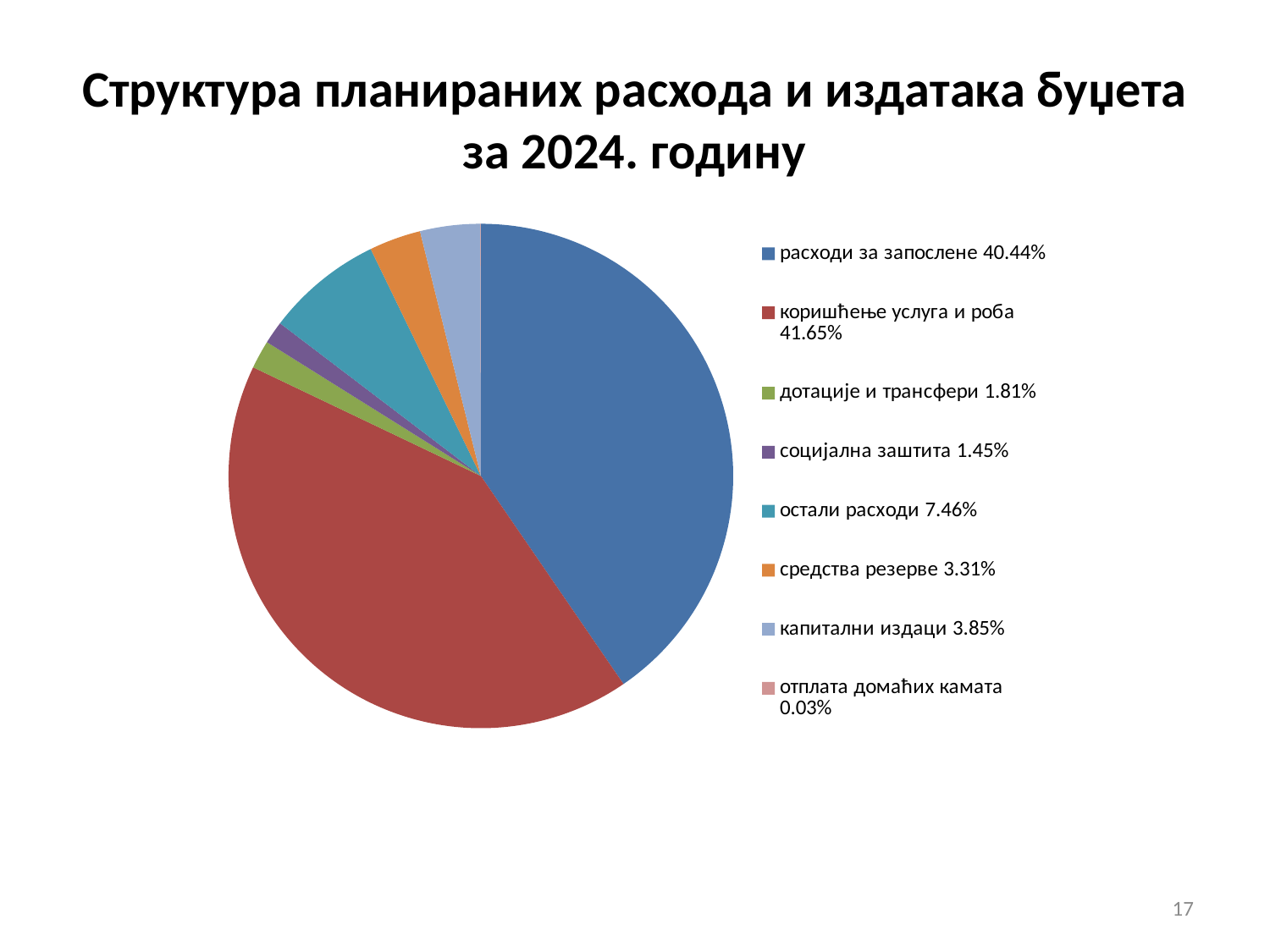
What is the share for капитални издаци? 3.85% How many categories does the legend list? 8 What is the share for расходи за запослене? 40.44% What is the share for отплата домаћих камата? 0.03% What is the title of the chart slide? Структура планираних расхода и издатака буџета за 2024. годину Which category has the largest share of the pie? коришћење услуга и роба What kind of chart is shown on the slide? pie chart Which category has the smallest share of the pie? отплата домаћих камата What is the share for остали расходи? 7.46% What is the share for коришћење услуга и роба? 41.65% Which is larger, the share for средства резерве or the share for капитални издаци? капитални издаци What is the difference between the shares of коришћење услуга и роба and расходи за запослене? 1.21%